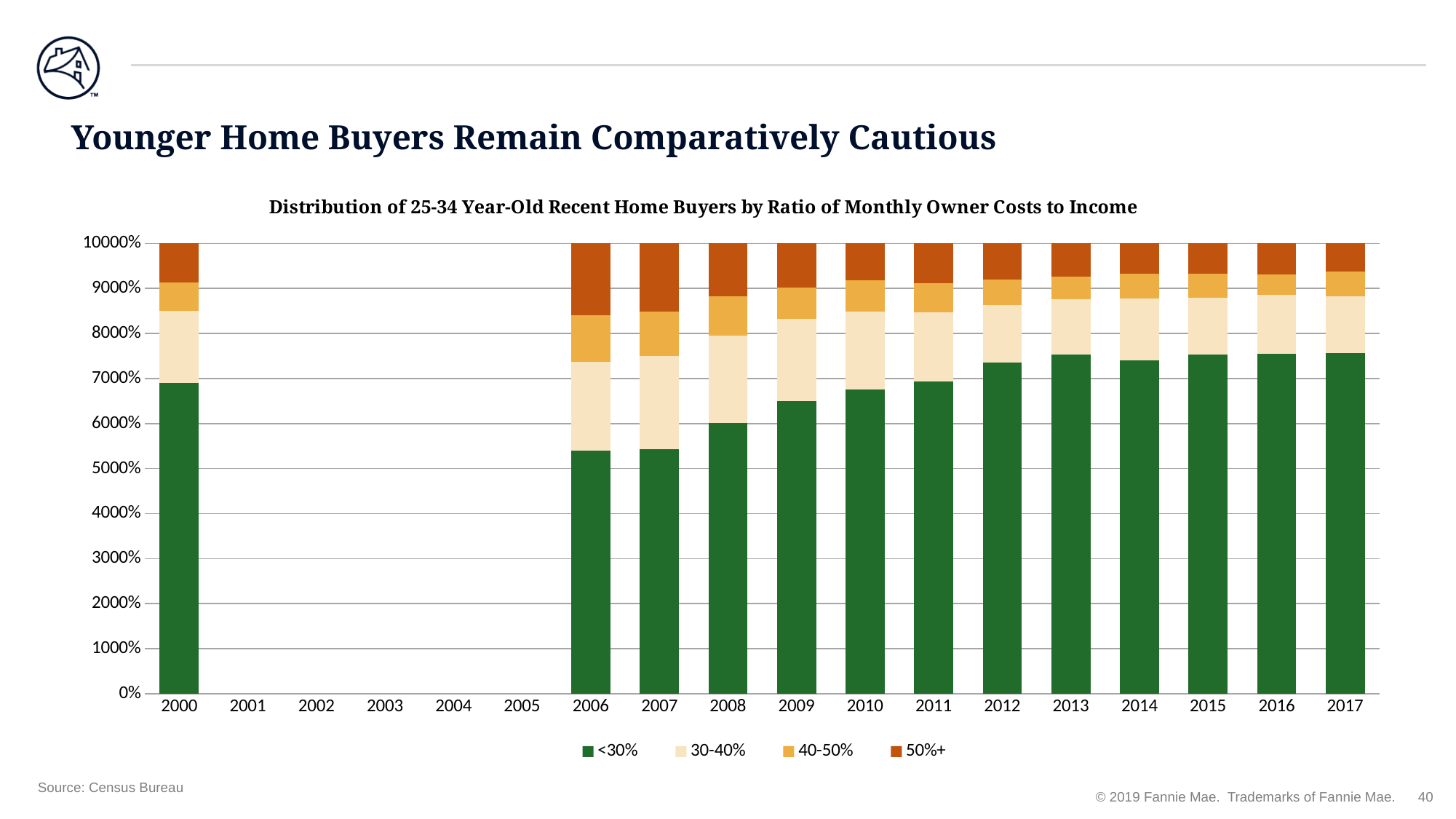
Is the value of the <30% segment for 2017 greater or less than 7000%? greater Is the value of the <30% segment for 2006 greater or less than 5000%? greater How many year labels appear along the x axis? 18 How many years have bars plotted in the chart? 13 From 2006 to 2017, does the <30% segment generally rise or fall? rise What kind of chart is shown on the slide? Stacked bar chart How many series does the legend list? 4 Which year has the larger <30% segment, 2006 or 2017? 2017 Is the value of the <30% segment for 2009 greater or less than 6000%? greater What is the title of the chart? Distribution of 25-34 Year-Old Recent Home Buyers by Ratio of Monthly Owner Costs to Income Which year has the larger 50%+ segment, 2006 or 2017? 2006